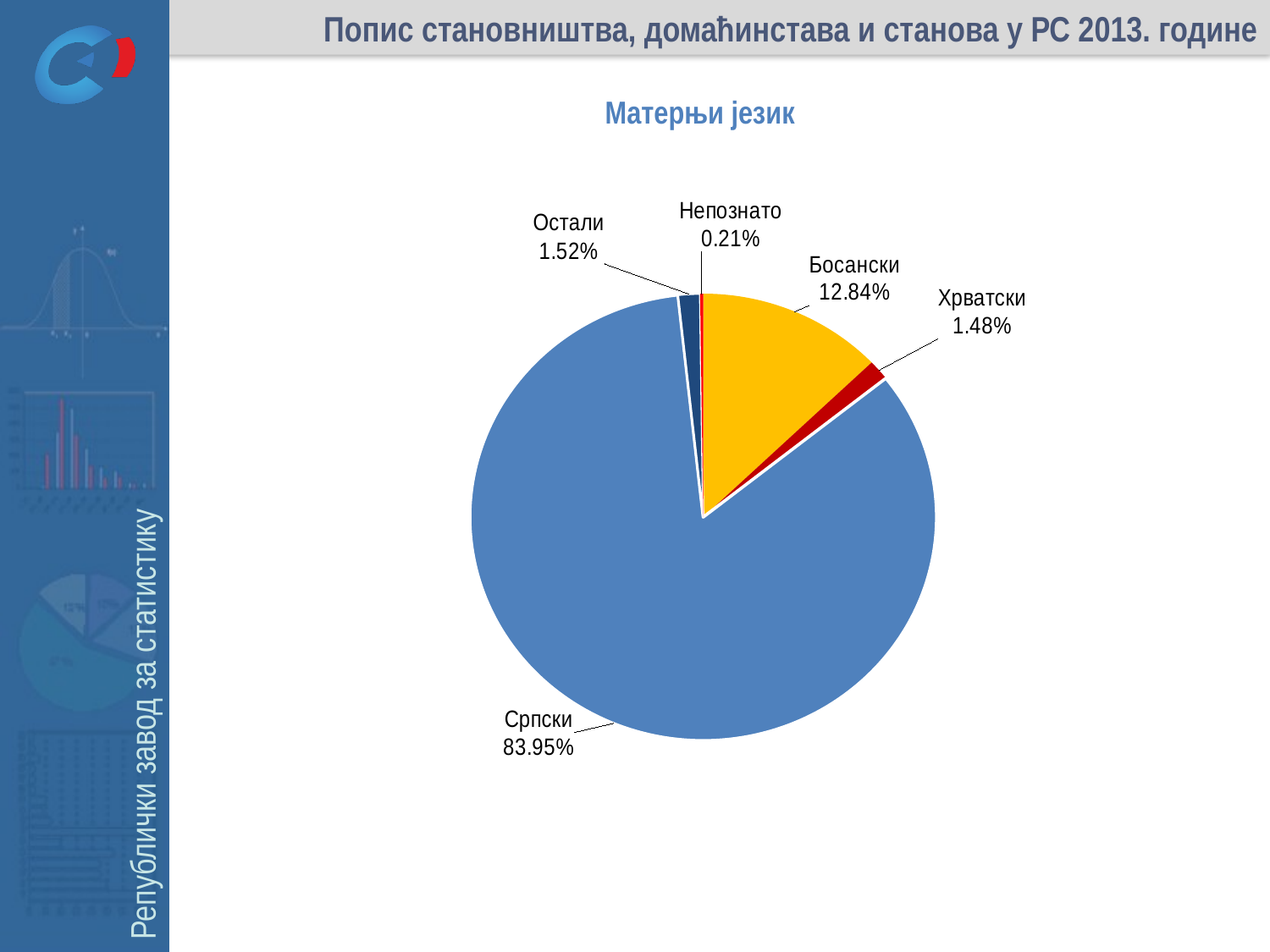
What type of chart is shown on the slide? pie chart What share of the pie does Хрватски have? 1.48% Which category has the smallest slice of the pie? Непознато What share of the pie does Српски have? 83.95% What share of the pie does Остали have? 1.52% Which is larger, the share of Босански or the share of Хрватски? Босански What share of the pie does Непознато have? 0.21% What share of the pie does Босански have? 12.84% How many slices does the pie chart have? 5 What is the difference between the shares of Српски and Босански? 71.11% What is the title of the chart? Матерњи језик Which category has the largest slice of the pie? Српски